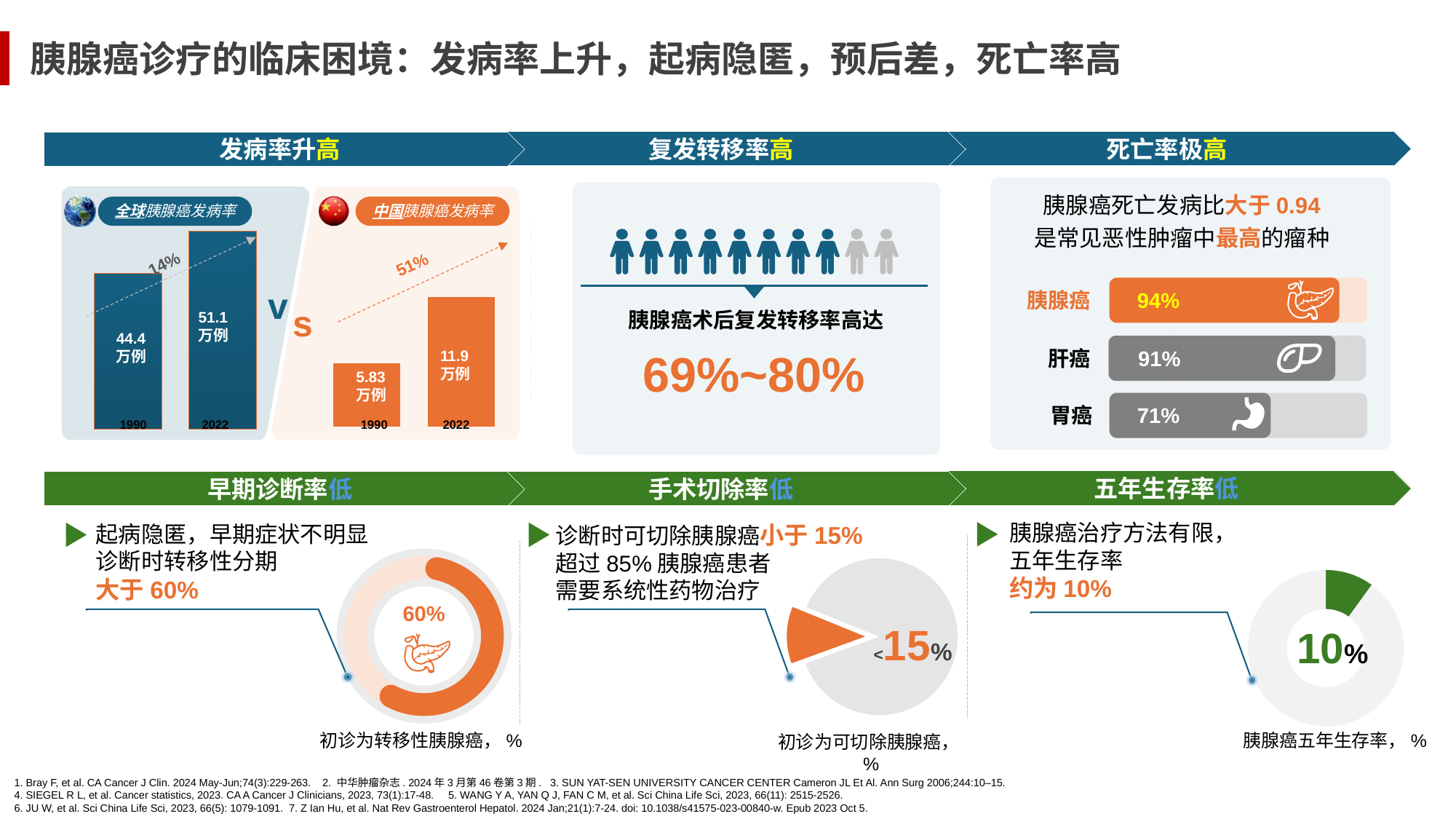
In the 中国胰腺癌发病率 bar chart, what percentage increase is shown between 1990 and 2022? 51% In the 全球胰腺癌发病率 bar chart, what percentage increase is shown between 1990 and 2022? 14% In the 中国胰腺癌发病率 bar chart, what is the value for 1990? 5.83万例 In the 全球胰腺癌发病率 bar chart, what is the value for 1990? 44.4万例 In the 中国胰腺癌发病率 bar chart, what is the value for 2022? 11.9万例 In the 死亡率极高 horizontal bar chart, which category has the lowest value? 胃癌 In the 死亡率极高 horizontal bar chart, what is the difference between 胰腺癌 and 胃癌? 23% In the 死亡率极高 horizontal bar chart, what is the value for 肝癌? 91% In the 中国胰腺癌发病率 bar chart, do the values rise or fall from 1990 to 2022? rise In the 全球胰腺癌发病率 bar chart, what is the value for 2022? 51.1万例 What kind of chart is used for 胰腺癌五年生存率 at the bottom right of the slide? donut chart In the 死亡率极高 horizontal bar chart, how many categories are shown? 3